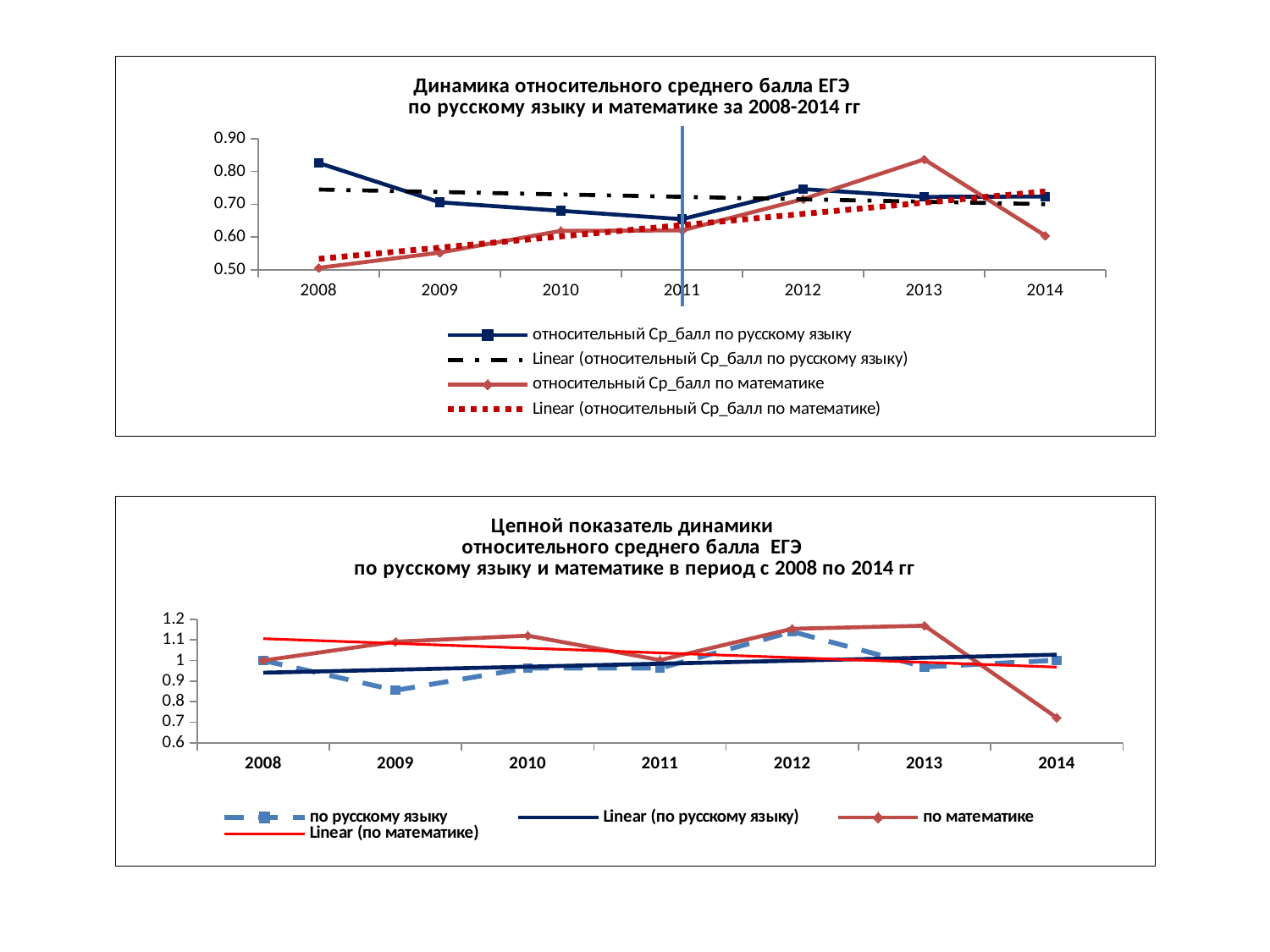
In the bottom chart, is the value for 'по русскому языку' in 2009 greater or less than 0.9? less In the top chart, which series has the larger value in 2013: 'относительный Ср_балл по русскому языку' or 'относительный Ср_балл по математике'? относительный Ср_балл по математике In the top chart, in which year is the value for 'относительный Ср_балл по математике' highest? 2013 In the top chart, how many years are shown on the x axis? 7 In the top chart, is the value for 'относительный Ср_балл по русскому языку' in 2008 greater or less than 0.80? greater In the top chart, in which year is the value for 'относительный Ср_балл по русскому языку' highest? 2008 In the bottom chart, which series has the larger value in 2010: 'по русскому языку' or 'по математике'? по математике In the bottom chart, 'Цепной показатель динамики', in which year is the value for 'по математике' lowest? 2014 In the top chart, in which year is the value for 'относительный Ср_балл по математике' lowest? 2008 In the top chart, how many entries does the legend list? 4 What kind of chart is the top chart, 'Динамика относительного среднего балла ЕГЭ по русскому языку и математике за 2008-2014 гг'? line chart In the top chart, does the value for 'относительный Ср_балл по математике' rise or fall from 2008 to 2013? rise